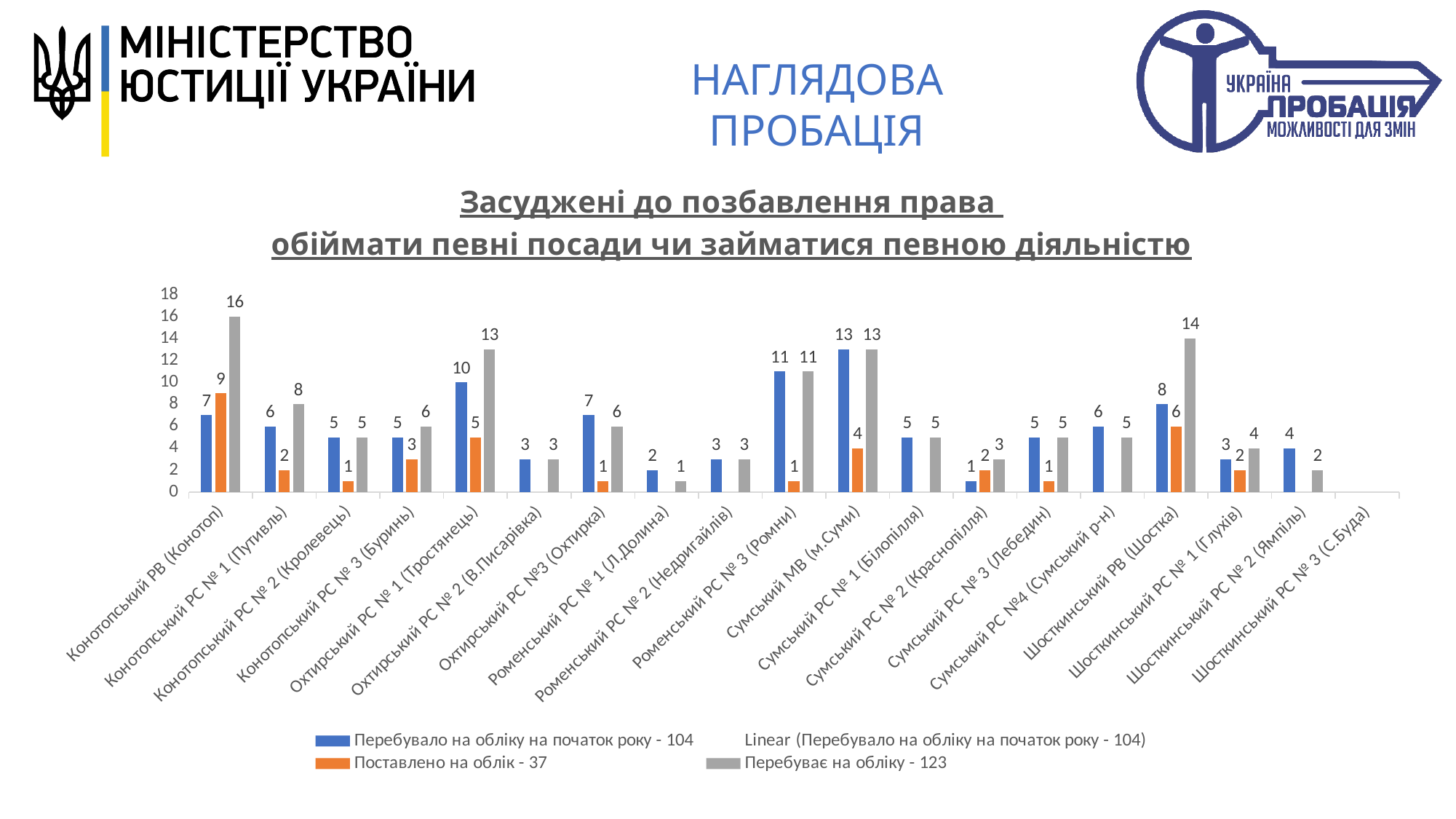
What is the difference between 'Перебуває на обліку - 123' and 'Перебувало на обліку на початок року - 104' for Шосткинський РВ (Шостка)? 6 How many entries does the legend list? 4 What type of chart is shown on the slide? bar chart Which category has the highest value for 'Перебуває на обліку - 123'? Конотопський РВ (Конотоп) What is the value of 'Перебуває на обліку - 123' for Конотопський РВ (Конотоп)? 16 How many categories are shown on the x axis? 19 What colour are the bars for 'Поставлено на облік - 37'? orange Which category has the highest value for 'Поставлено на облік - 37'? Конотопський РВ (Конотоп) What is the value of 'Поставлено на облік - 37' for Шосткинський РВ (Шостка)? 6 Which category has the highest value for 'Перебувало на обліку на початок року - 104'? Сумський МВ (м.Суми) Which is larger for Охтирський РС №3 (Охтирка): 'Перебувало на обліку на початок року - 104' or 'Перебуває на обліку - 123'? Перебувало на обліку на початок року - 104 What is the value of 'Перебувало на обліку на початок року - 104' for Охтирський РС № 1 (Тростянець)? 10